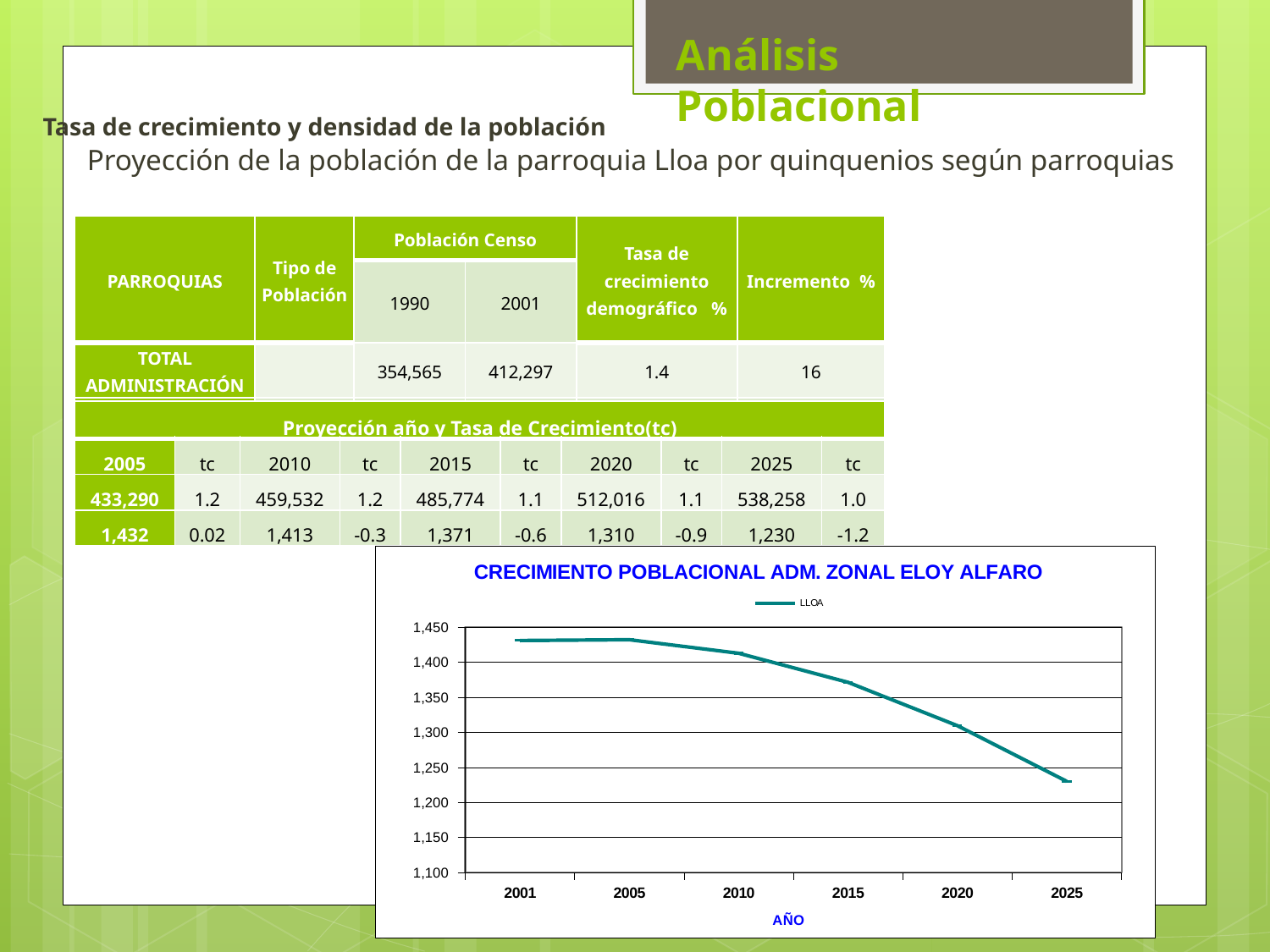
Is the value for 2020 greater or less than 1,350? less How many years are plotted along the x axis of the chart? 6 What is the name of the series shown in the chart legend? LLOA Which year has the lowest value in the chart? 2025 How many series does the chart legend list? 1 What is the title of the chart? CRECIMIENTO POBLACIONAL ADM. ZONAL ELOY ALFARO Is the value for 2025 greater or less than 1,250? less Do the values in the chart rise or fall from 2001 to 2025? fall Is the value for 2015 greater or less than 1,400? less What kind of chart is shown on the slide? line chart Which year has the larger value, 2015 or 2025? 2015